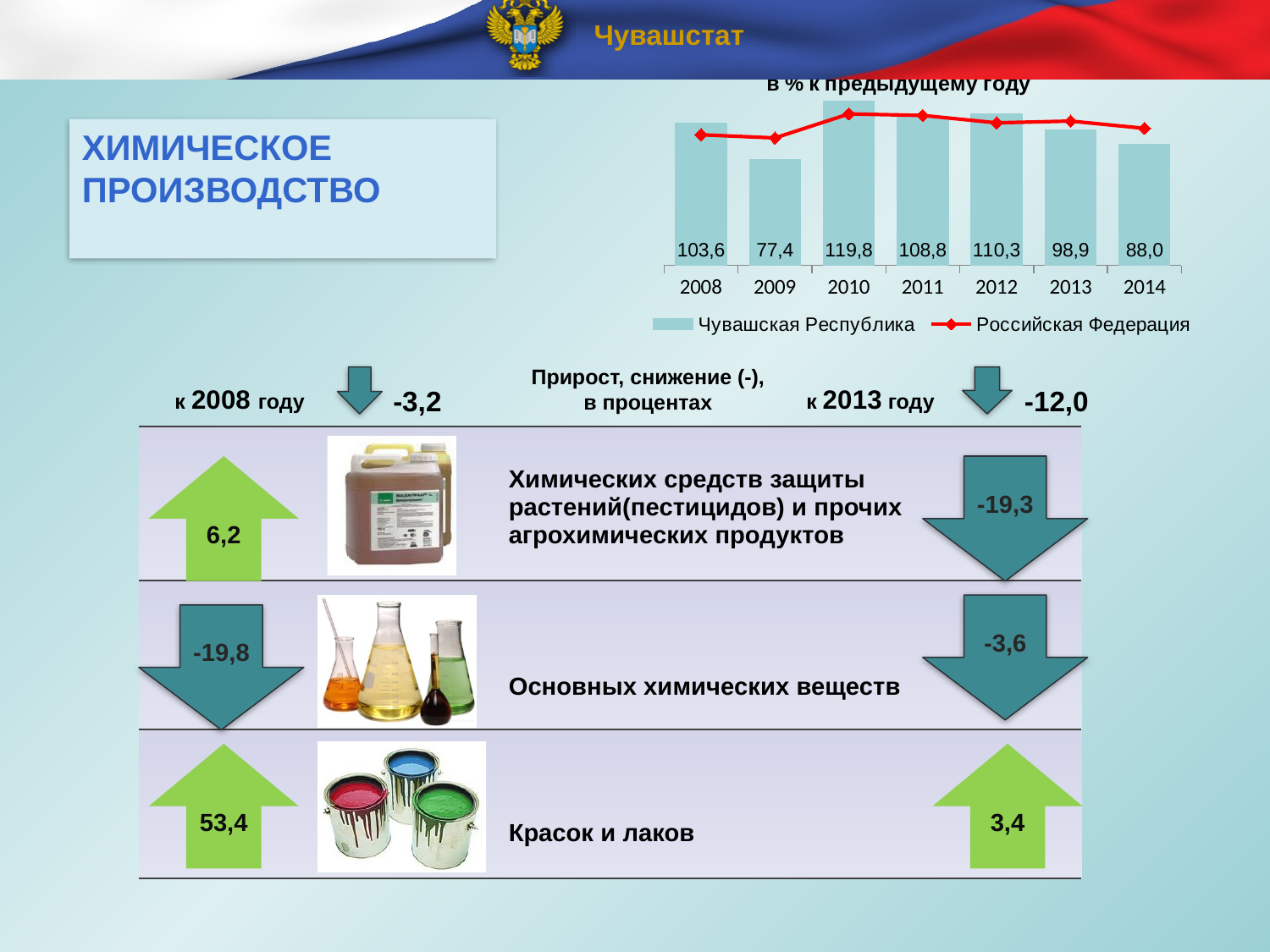
Which year has the larger Chuvash Republic value, 2011 or 2012? 2012 In which year is the Chuvash Republic bar the lowest? 2009 In which year is the Chuvash Republic bar the highest? 2010 What is the value for the Chuvash Republic (Чувашская Республика) in 2010? 119,8 What is the value for the Chuvash Republic in 2014? 88,0 What kind of chart is used for the Chuvash Republic series? bar chart Which series is shown as a red line with markers? Российская Федерация What is the difference between the Chuvash Republic values for 2010 and 2009? 42,4 Do the Chuvash Republic values rise or fall from 2012 to 2014? fall What is the value for the Chuvash Republic in 2009? 77,4 How many years are shown on the x axis of the chart? 7 How many series does the chart legend list? 2